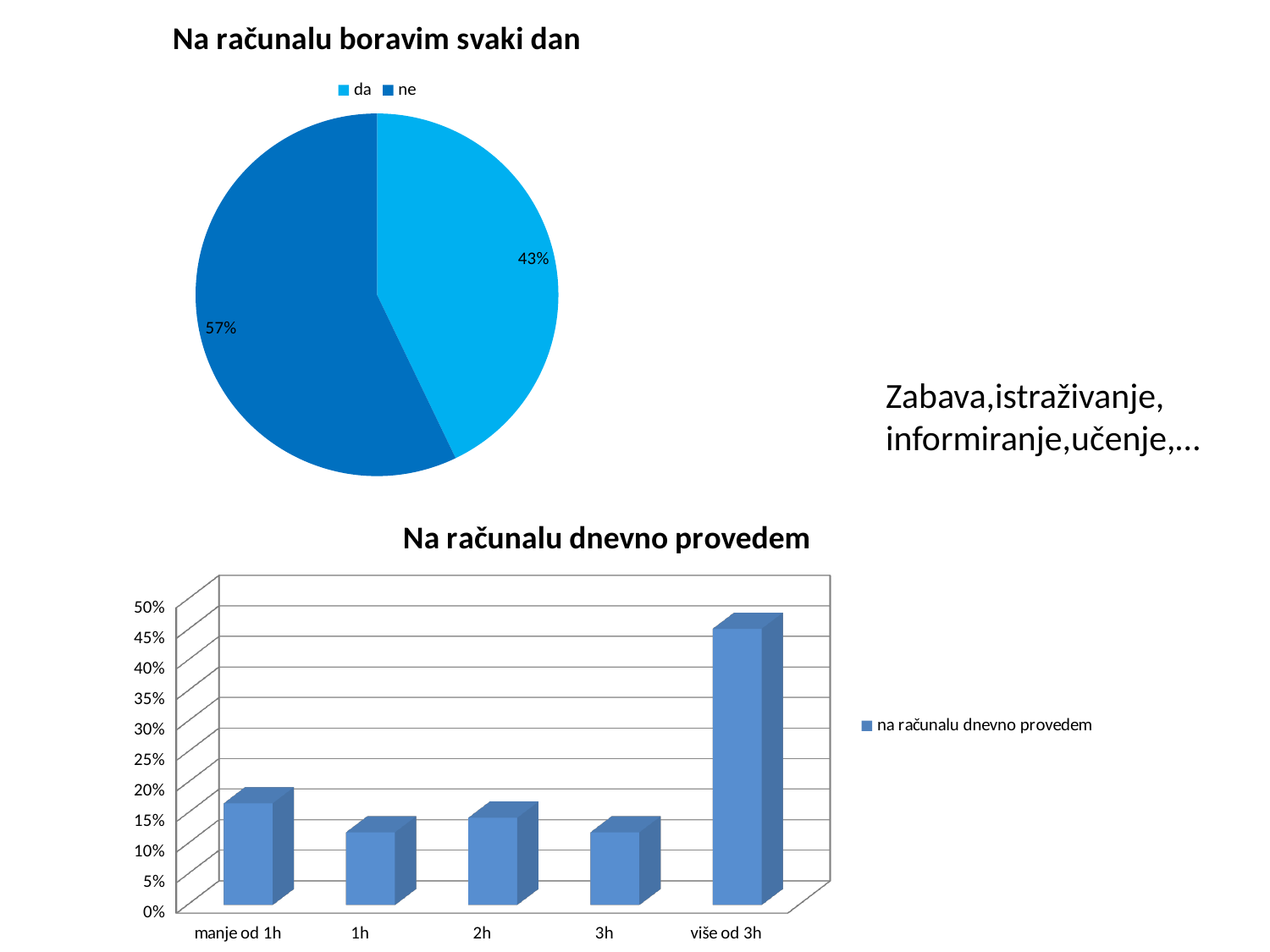
In the pie chart 'Na računalu boravim svaki dan', what percentage is shown for 'ne'? 57% In the pie chart 'Na računalu boravim svaki dan', which slice is larger, 'da' or 'ne'? ne In the bar chart 'Na računalu dnevno provedem', is the value for 'više od 3h' greater or less than 40%? greater What type of chart is the top chart titled 'Na računalu boravim svaki dan'? pie chart How many categories are shown on the x axis of the bar chart 'Na računalu dnevno provedem'? 5 In the pie chart 'Na računalu boravim svaki dan', what is the difference in percentage points between 'ne' and 'da'? 14 In the bar chart 'Na računalu dnevno provedem', which is larger, the value for '2h' or the value for 'više od 3h'? više od 3h What type of chart is the bottom chart titled 'Na računalu dnevno provedem'? bar chart In the bar chart 'Na računalu dnevno provedem', is the value for 'manje od 1h' greater or less than 20%? less In the bar chart 'Na računalu dnevno provedem', which category has the highest value? više od 3h How many slices does the pie chart 'Na računalu boravim svaki dan' have? 2 In the pie chart 'Na računalu boravim svaki dan', what percentage is shown for 'da'? 43%